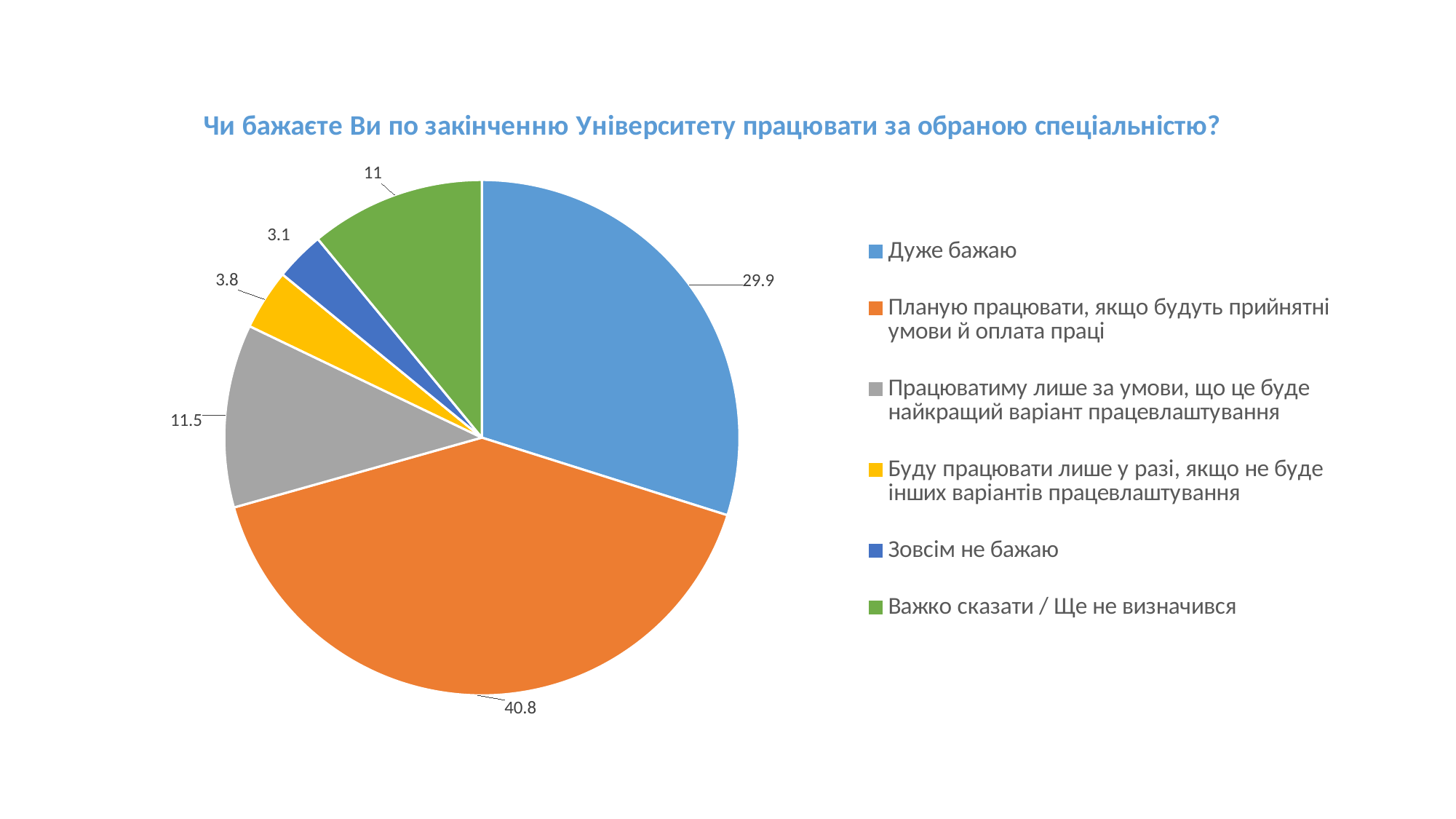
What is the difference between the values for "Планую працювати, якщо будуть прийнятні умови й оплата праці" and "Дуже бажаю"? 10.9 What is the value for "Важко сказати / Ще не визначився"? 11 What is the title of the chart? Чи бажаєте Ви по закінченню Університету працювати за обраною спеціальністю? How many categories does the pie chart have? 6 What type of chart is shown on the slide? pie chart Which category has the largest slice of the pie? Планую працювати, якщо будуть прийнятні умови й оплата праці What is the value for "Зовсім не бажаю"? 3.1 Which category has the smallest slice of the pie? Зовсім не бажаю Which is larger: the value for "Буду працювати лише у разі, якщо не буде інших варіантів працевлаштування" or the value for "Зовсім не бажаю"? Буду працювати лише у разі, якщо не буде інших варіантів працевлаштування What colour is the slice for "Працюватиму лише за умови, що це буде найкращий варіант працевлаштування"? grey What is the value for "Дуже бажаю"? 29.9 What is the value for "Планую працювати, якщо будуть прийнятні умови й оплата праці"? 40.8